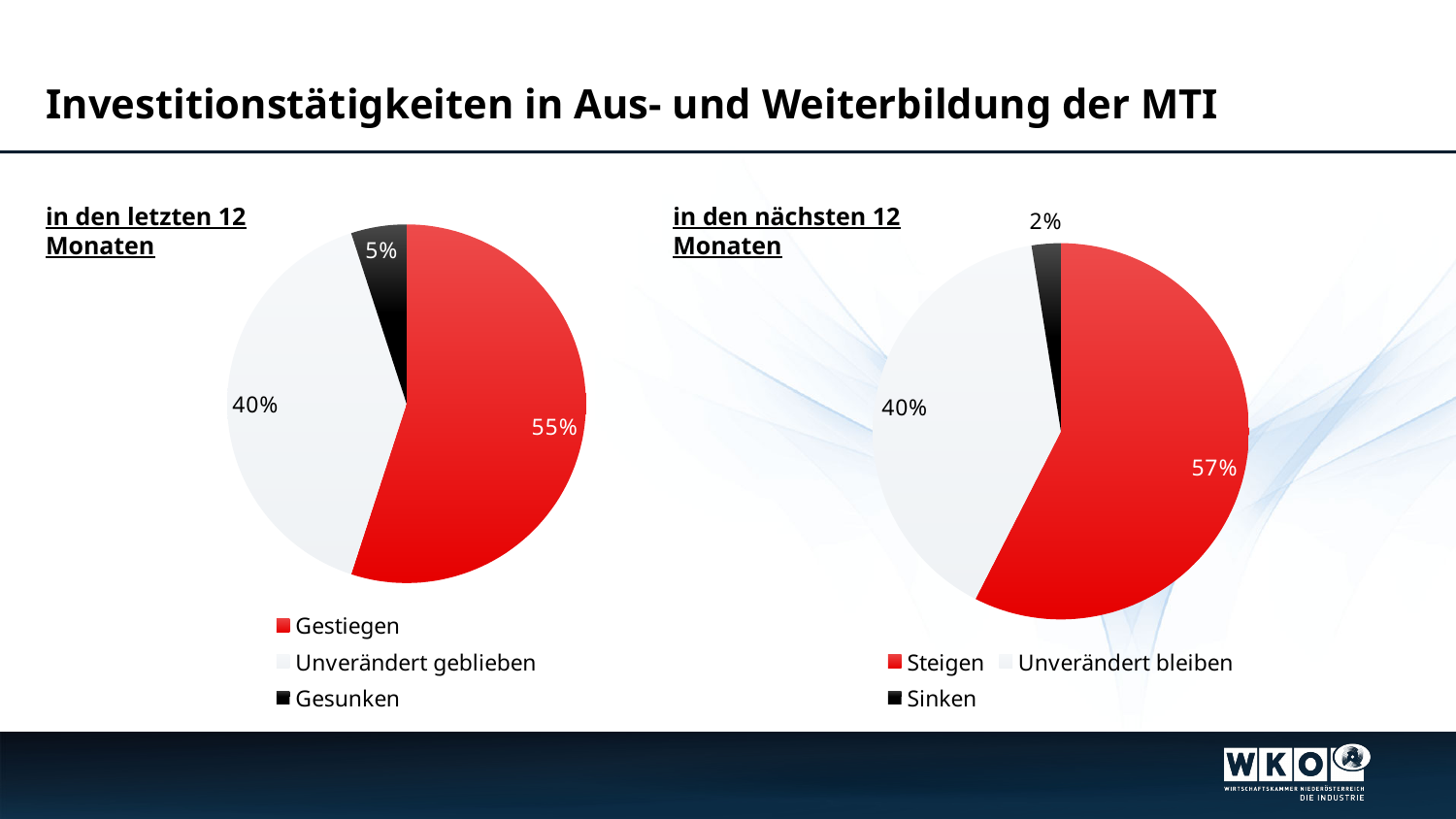
In the right pie chart (in den nächsten 12 Monaten), what share is labelled for Sinken? 2% In the left pie chart (in den letzten 12 Monaten), what share is labelled for Gesunken? 5% In the right pie chart (in den nächsten 12 Monaten), which category has the smallest share? Sinken In the left pie chart (in den letzten 12 Monaten), what share is labelled for Gestiegen? 55% In the left pie chart (in den letzten 12 Monaten), what is the difference between the Gestiegen and Unverändert geblieben shares? 15% How many categories does the legend of the left pie chart (in den letzten 12 Monaten) list? 3 In the right pie chart (in den nächsten 12 Monaten), what share is labelled for Unverändert bleiben? 40% In the right pie chart (in den nächsten 12 Monaten), what colour is the Steigen slice? Red In the right pie chart (in den nächsten 12 Monaten), what share is labelled for Steigen? 57% What kind of chart is used on the right (in den nächsten 12 Monaten)? Pie chart In the left pie chart (in den letzten 12 Monaten), which category has the largest share? Gestiegen Which is larger: the Gestiegen share in the left chart or the Steigen share in the right chart? Steigen in the right chart